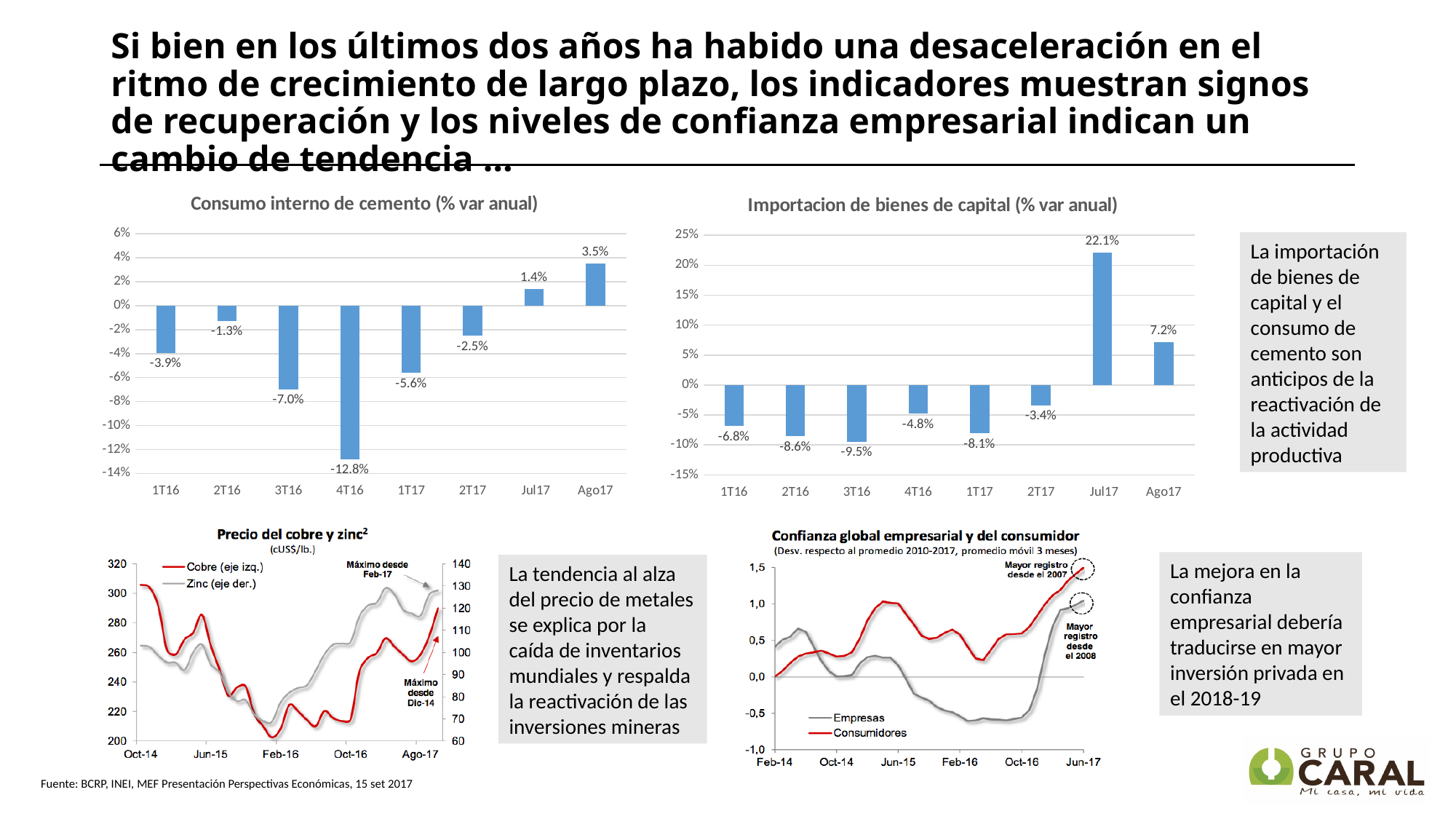
What kind of chart is 'Importacion de bienes de capital (% var anual)'? Bar chart In the 'Consumo interno de cemento (% var anual)' chart, what is the difference between the values for Ago17 and Jul17? 2.1 percentage points How many periods are shown on the x axis of the 'Consumo interno de cemento (% var anual)' chart? 8 In the 'Importacion de bienes de capital (% var anual)' chart, which period has the lowest value? 3T16 In the 'Importacion de bienes de capital (% var anual)' chart, what is the difference between the values for Jul17 and Ago17? 14.9 percentage points In the 'Importacion de bienes de capital (% var anual)' chart, which is larger, the value for 4T16 or the value for 2T17? 2T17 How many series does the legend of the 'Confianza global empresarial y del consumidor' chart list? 2 In the 'Consumo interno de cemento (% var anual)' chart, do the values rise or fall from 1T17 to Ago17? Rise In the 'Consumo interno de cemento (% var anual)' chart, what is the value for 4T16? -12.8% In the 'Consumo interno de cemento (% var anual)' chart, which period has the lowest value? 4T16 In the 'Consumo interno de cemento (% var anual)' chart, which period has the highest value? Ago17 In the 'Importacion de bienes de capital (% var anual)' chart, what is the value for Jul17? 22.1%